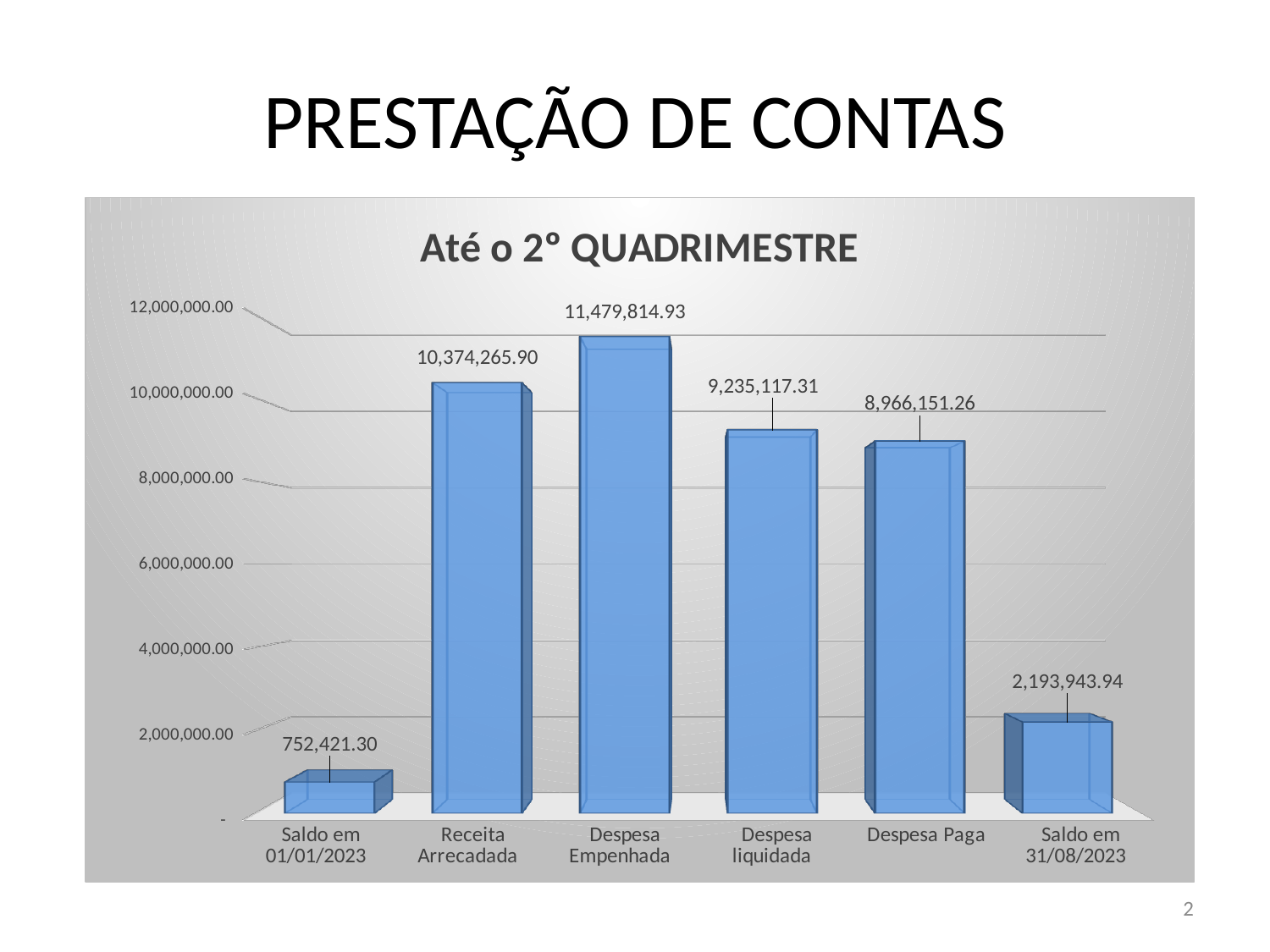
What is the difference between Despesa liquidada and Despesa Paga? 268,966.05 Is the value for Saldo em 31/08/2023 greater or less than 2,000,000.00? greater Which category has the lowest value? Saldo em 01/01/2023 What is the value for Despesa Empenhada? 11,479,814.93 What is the difference between Despesa Empenhada and Receita Arrecadada? 1,105,549.03 Which is larger, Despesa liquidada or Despesa Paga? Despesa liquidada How many categories are shown in the chart? 6 Which category has the highest value? Despesa Empenhada What is the value for Despesa Paga? 8,966,151.26 What is the value for Saldo em 31/08/2023? 2,193,943.94 What is the value for Receita Arrecadada? 10,374,265.90 What is the title of the chart? Até o 2º QUADRIMESTRE